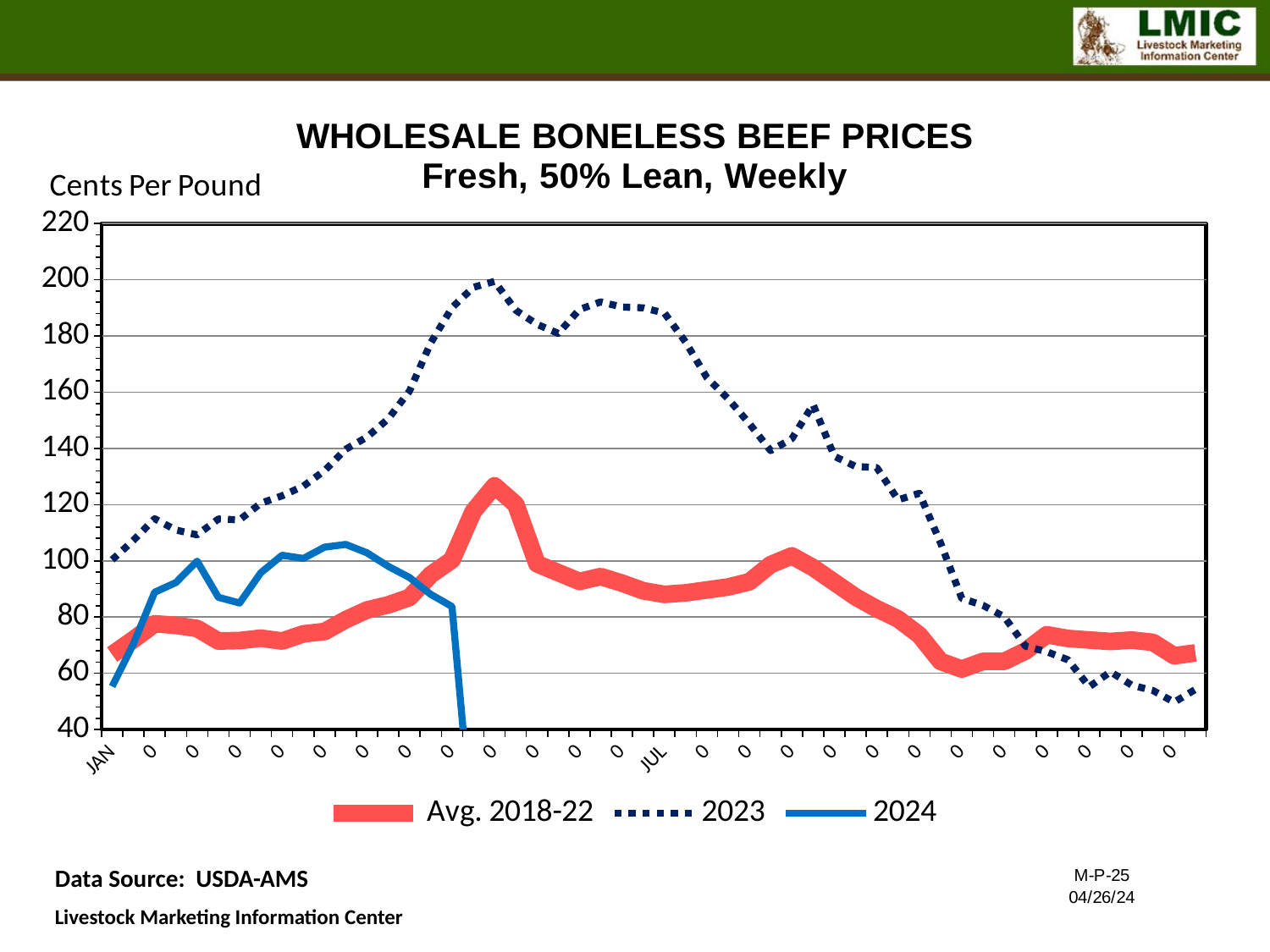
What is the title of the chart? WHOLESALE BONELESS BEEF PRICES Fresh, 50% Lean, Weekly How many series does the legend list? 3 Is the value of the 2023 series at JUL greater or less than 160? greater At JUL, which is larger: the 2023 series or the Avg. 2018-22 series? 2023 What unit is shown on the vertical axis label? Cents Per Pound Is the value of the 2024 series at JAN greater or less than 80? less Is the final value of the 2023 series at the right end of the chart greater or less than 60? less Does the 2023 series rise or fall from JUL to the end of the year? fall Which series reaches the highest value on the chart? 2023 What kind of chart is shown on the slide? line chart